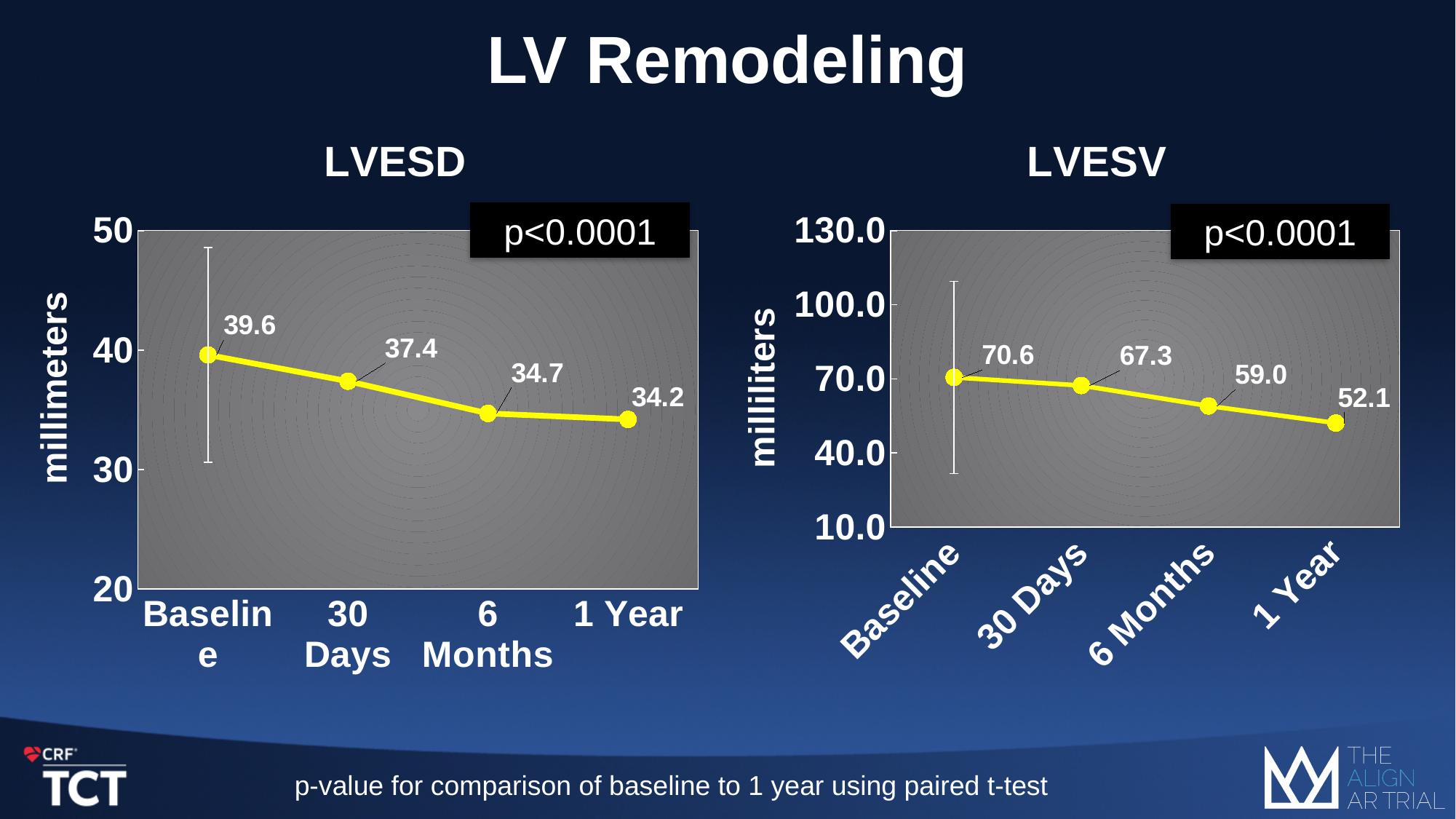
In the LVESV chart, what is the difference between the Baseline value and the 1 Year value? 18.5 How many time points are plotted in the LVESD chart? 4 In the LVESD chart, which time point has the highest value? Baseline In the LVESD chart, do the values rise or fall from Baseline to 1 Year? fall In the LVESD chart, what is the difference between the Baseline value and the 1 Year value? 5.4 In the LVESV chart, what is the value at 30 Days? 67.3 In the LVESD chart, what is the value at 1 Year? 34.2 In the LVESV chart, what is the value at 6 Months? 59.0 What type of chart is the LVESV chart? line chart In the LVESD chart, what is the value at Baseline? 39.6 In the LVESV chart, which time point has the lowest value? 1 Year In the LVESV chart, is the value at 30 Days larger or smaller than the value at 6 Months? larger